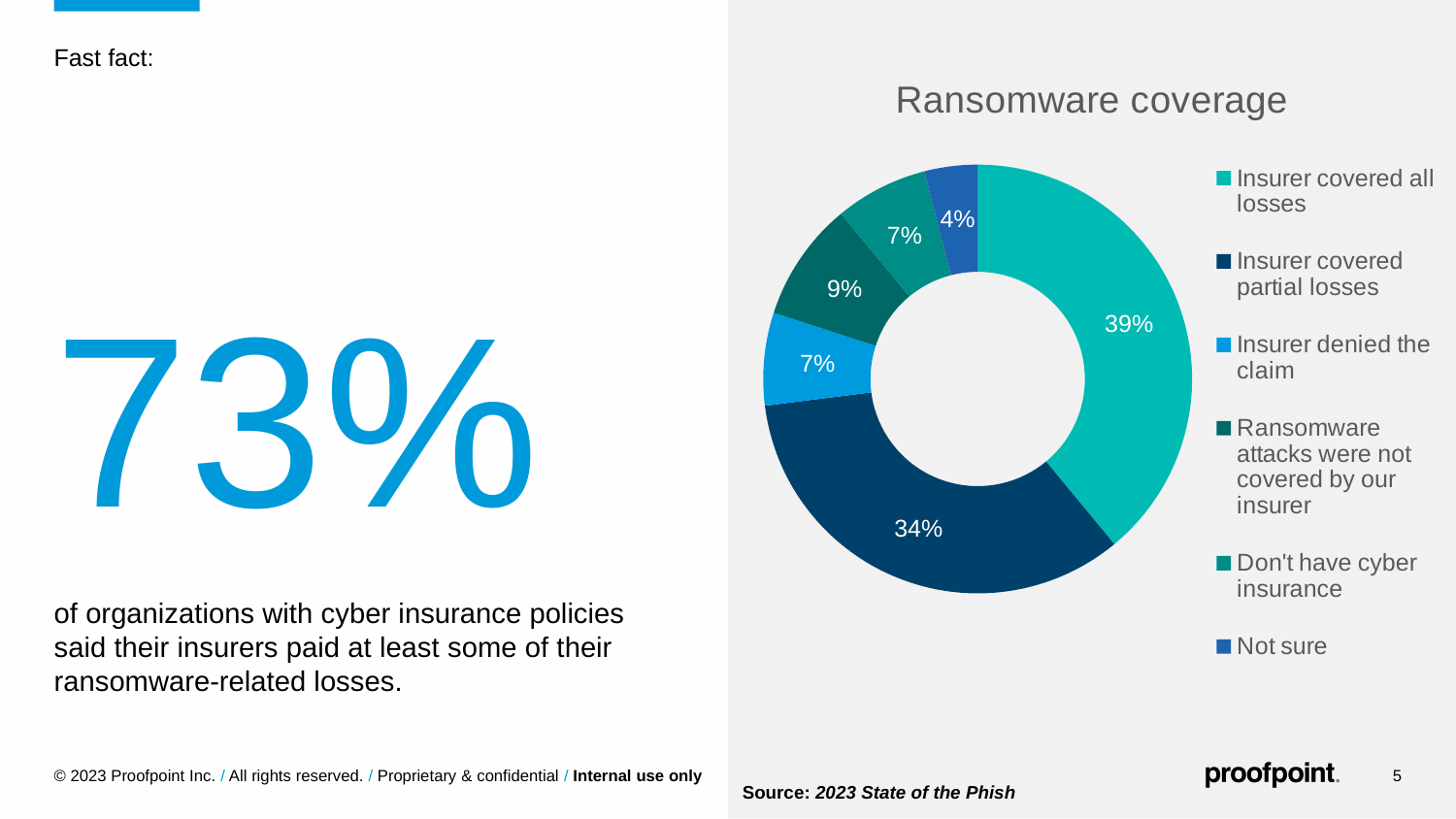
What type of chart is shown on the slide? Pie chart (donut) What is the combined share of 'Insurer covered all losses' and 'Insurer covered partial losses'? 73% What is the title of the chart? Ransomware coverage What percentage of respondents said their insurer covered all losses? 39% What share of the pie is 'Ransomware attacks were not covered by our insurer'? 9% Which is larger: 'Ransomware attacks were not covered by our insurer' or 'Insurer denied the claim'? Ransomware attacks were not covered by our insurer How many categories does the legend list? 6 Which category has the largest share of the pie? Insurer covered all losses What percentage of respondents said their insurer covered partial losses? 34% Which category has the smallest share of the pie? Not sure What percentage of respondents answered 'Not sure'? 4% What is the difference between the 'Insurer covered all losses' and 'Insurer covered partial losses' shares? 5%